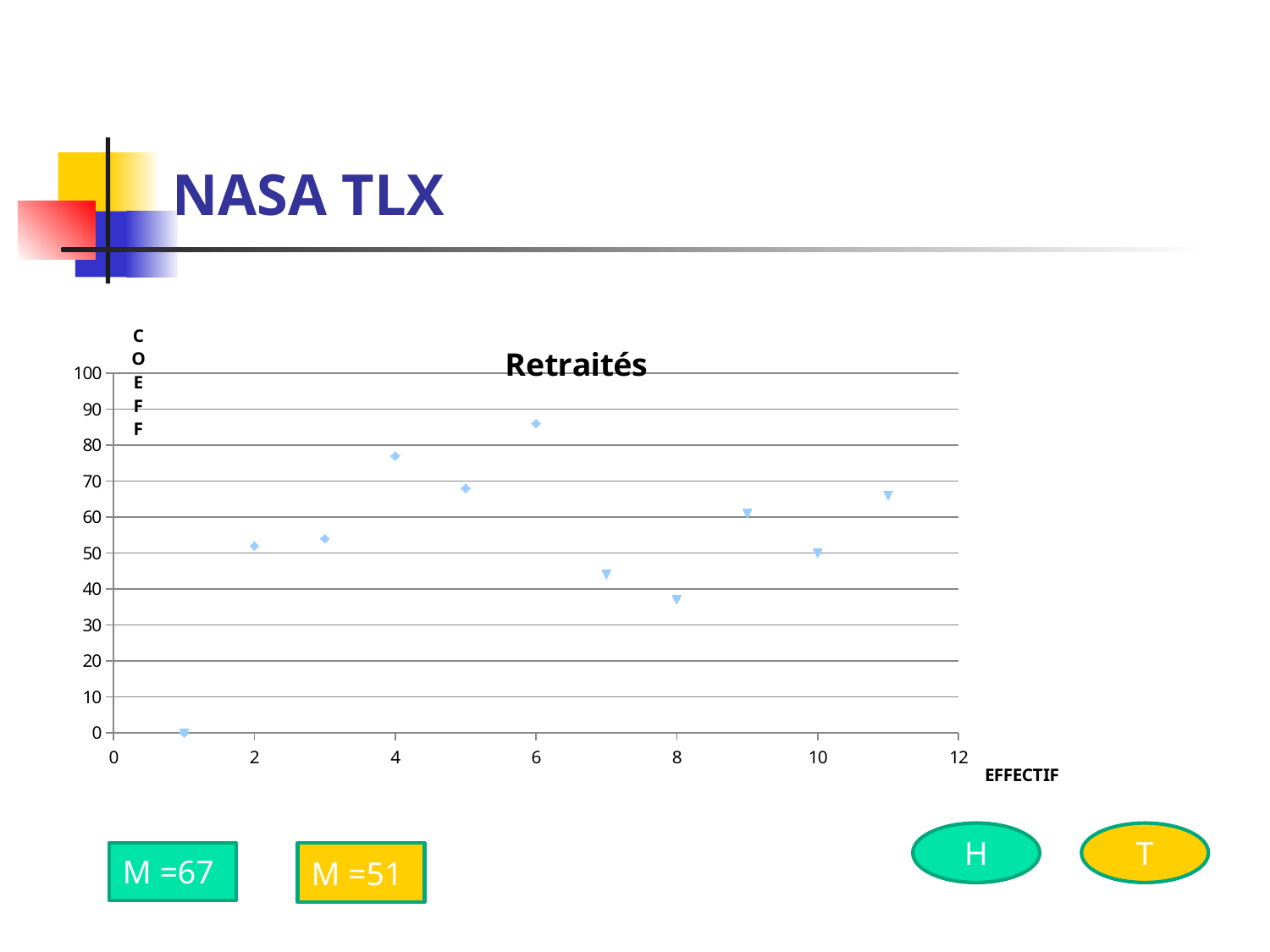
At which x value (EFFECTIF) is the highest point on the chart? 6 What label is shown on the x axis of the chart? EFFECTIF Which point has the larger value, the one at EFFECTIF 5 or the one at EFFECTIF 7? EFFECTIF 5 How many data points are plotted on the chart? 11 Which point has the larger value, the one at EFFECTIF 9 or the one at EFFECTIF 10? EFFECTIF 9 Is the value of the point at EFFECTIF 6 greater or less than 80? greater What is the value of the point at EFFECTIF 1? 0 At which x value (EFFECTIF) is the lowest point on the chart? 1 Is the value of the point at EFFECTIF 4 greater or less than 70? greater What is the title of the chart? Retraités What kind of chart is shown on the slide? scatter chart Is the value of the point at EFFECTIF 8 greater or less than 40? less